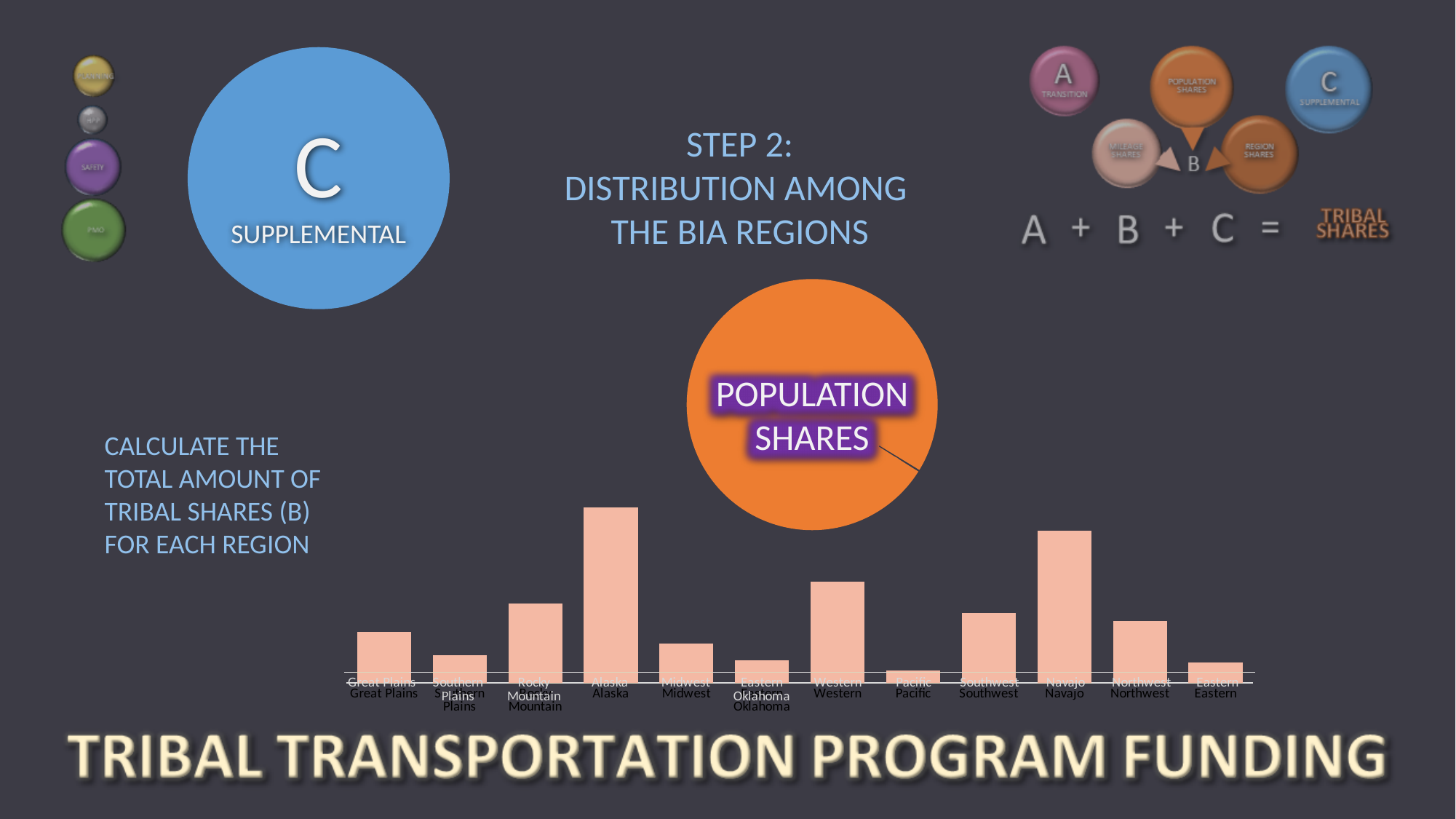
Does the bar chart display a legend? No Which bar is taller, Western or Midwest? Western What is the label of the first region on the left of the x axis? Great Plains Which bar is taller, Northwest or Eastern? Northwest Which bar is taller, Midwest or Eastern Oklahoma? Midwest Which region has the second tallest bar in the chart? Navajo What kind of chart is shown on the slide? bar chart Which region has the tallest bar in the chart? Alaska How many regions are shown on the x axis of the bar chart? 12 Which region has the shortest bar in the chart? Pacific